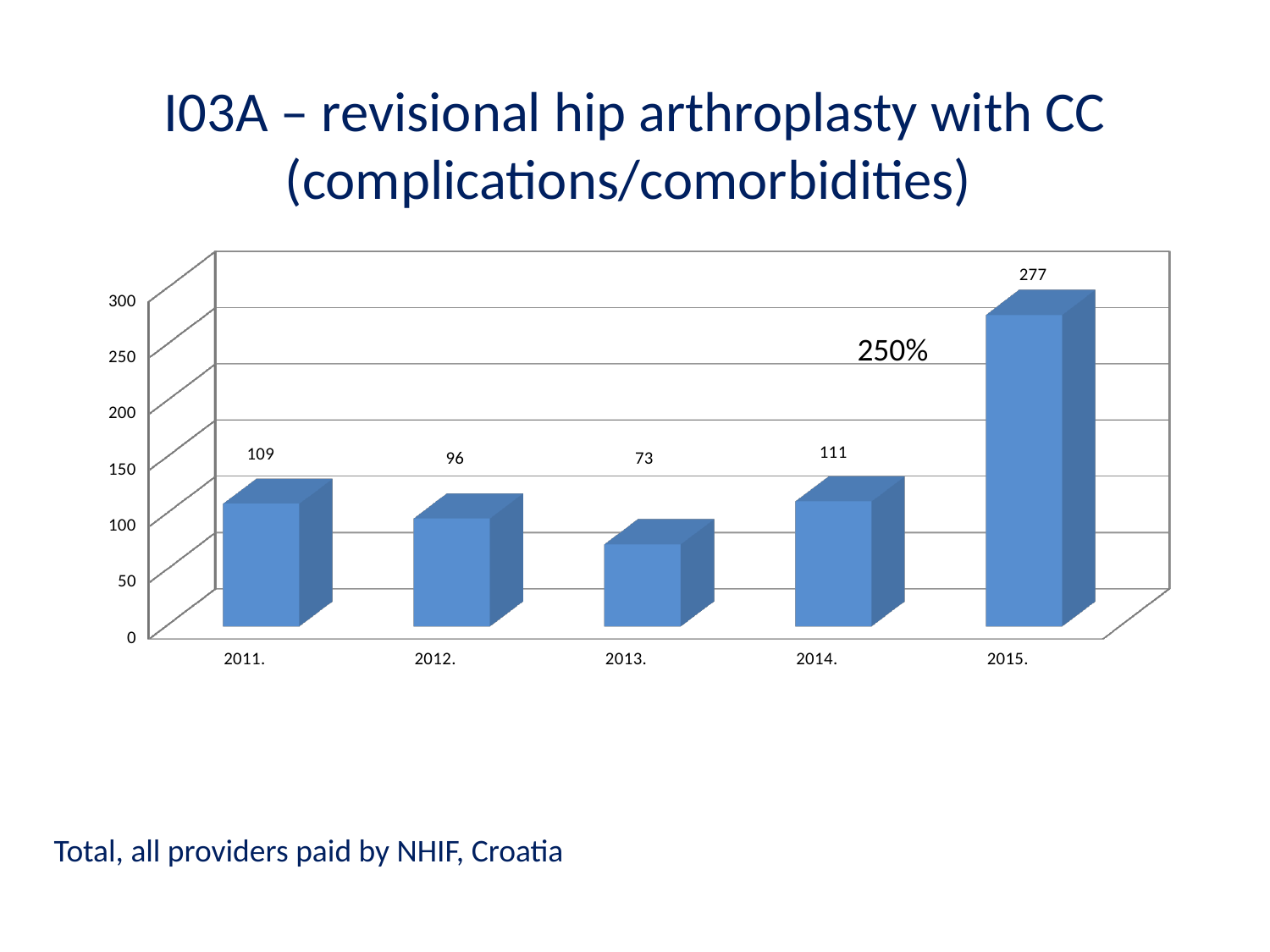
What is the difference between the values for 2011. and 2012.? 13 What is the value for 2015.? 277 How many years are shown on the x axis? 5 What percentage annotation is printed above the 2014. bar? 250% What kind of chart is shown on the slide? bar chart Which year has the highest value? 2015. Is the value for 2015. greater or less than 250? greater What is the value for 2013.? 73 Which year has the lowest value? 2013. Which is larger, the value for 2012. or the value for 2014.? 2014. What is the value for 2011.? 109 What is the difference between the values for 2015. and 2014.? 166